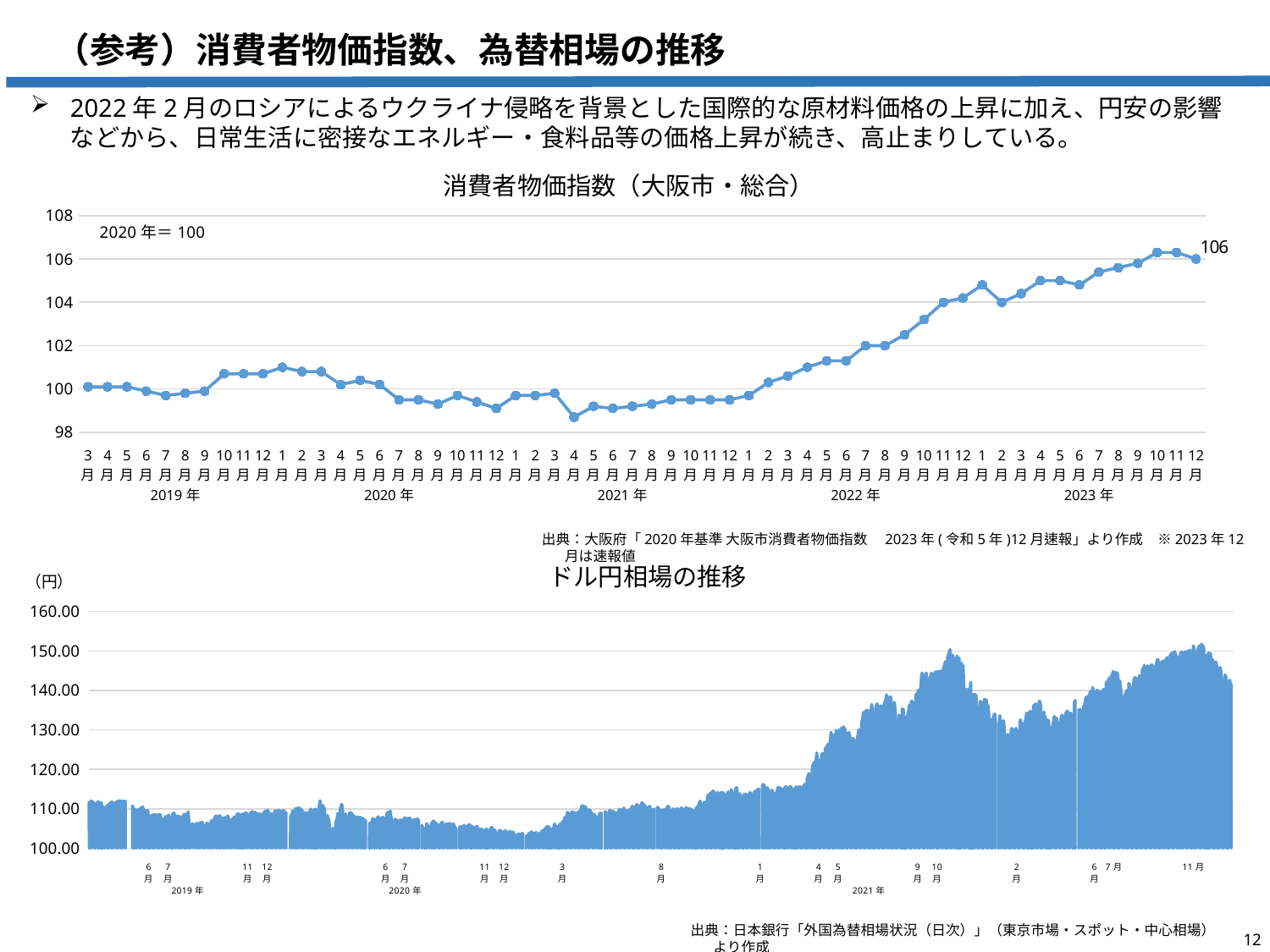
In the top chart 消費者物価指数（大阪市・総合）, which is larger, the value for 2019年3月 or the value for 2023年12月? 2023年12月 In the top chart 消費者物価指数（大阪市・総合）, what value is labelled for 2023年12月? 106 In the top chart 消費者物価指数（大阪市・総合）, is the value for 2023年10月 greater or less than 104? greater In the top chart 消費者物価指数（大阪市・総合）, which month has the lowest value? 2021年4月 In the top chart 消費者物価指数（大阪市・総合）, do the values rise or fall from 2022年1月 to 2023年10月? rise What kind of chart is the top chart titled 消費者物価指数（大阪市・総合）? line chart In the top chart 消費者物価指数（大阪市・総合）, which year is set as the base (=100)? 2020年 In the bottom chart ドル円相場の推移, what unit is shown on the vertical axis? 円 In the bottom chart ドル円相場の推移, is the value around 2019年6月 greater or less than 120.00? less What kind of chart is the bottom chart titled ドル円相場の推移? area chart